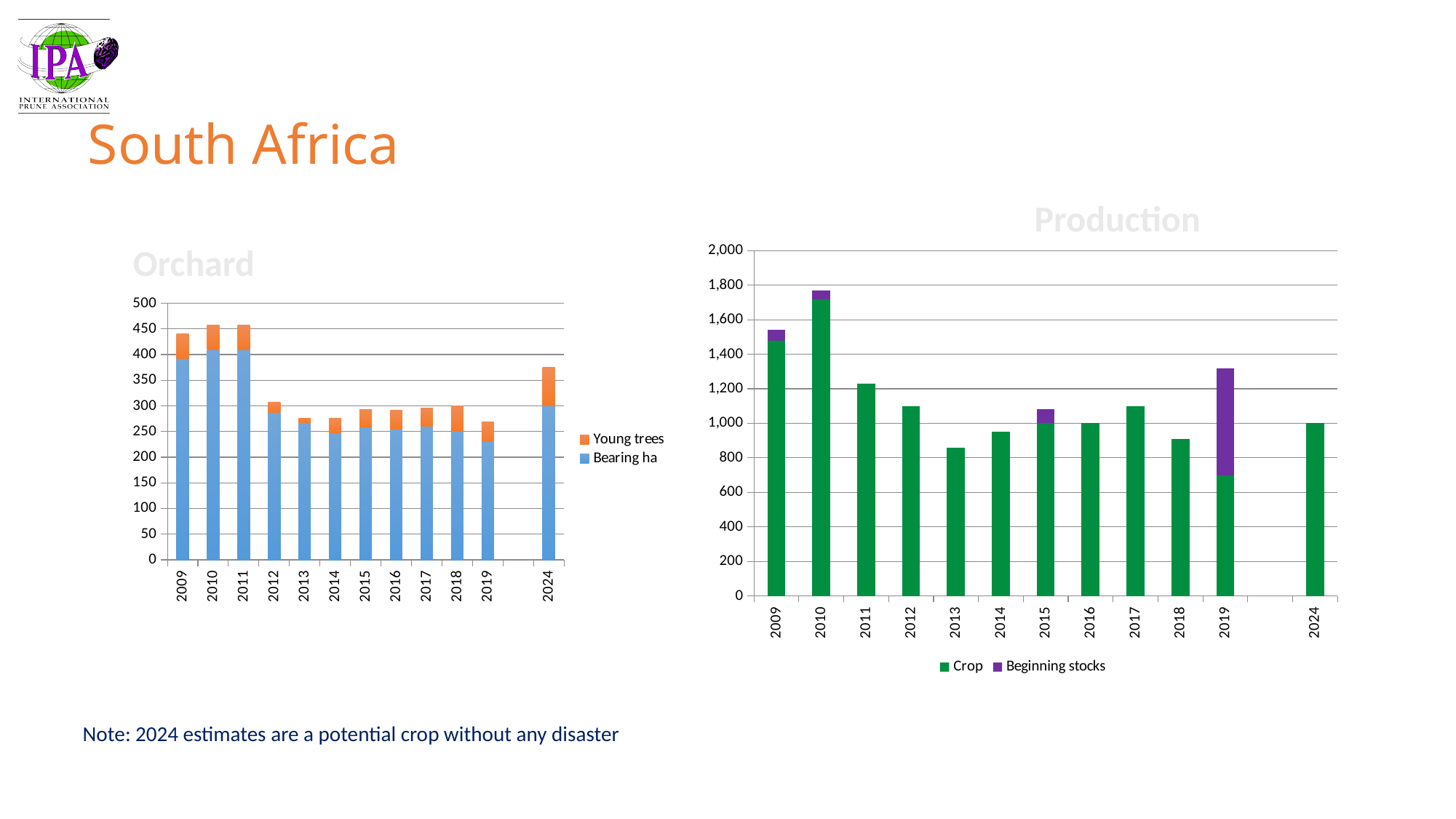
On the Production chart, which year has the lowest Crop value? 2019 On the Orchard chart, which year has the larger total bar, 2010 or 2012? 2010 On the Production chart, how many years are shown on the x axis? 12 On the Orchard chart, what are the two legend entries? Young trees and Bearing ha On the Orchard chart, how many series does the legend list? 2 On the Production chart, what kind of chart is shown? Bar chart On the Production chart, is the Crop value for 2013 greater or less than 1,000? less On the Production chart, is the total bar for 2010 greater or less than 1,600? greater On the Production chart, which year has the highest Crop value? 2010 On the Orchard chart, does the Bearing ha value rise or fall from 2009 to 2019? fall On the Production chart, how many series does the legend list? 2 On the Orchard chart, is the Bearing ha value for 2009 greater or less than 350? greater